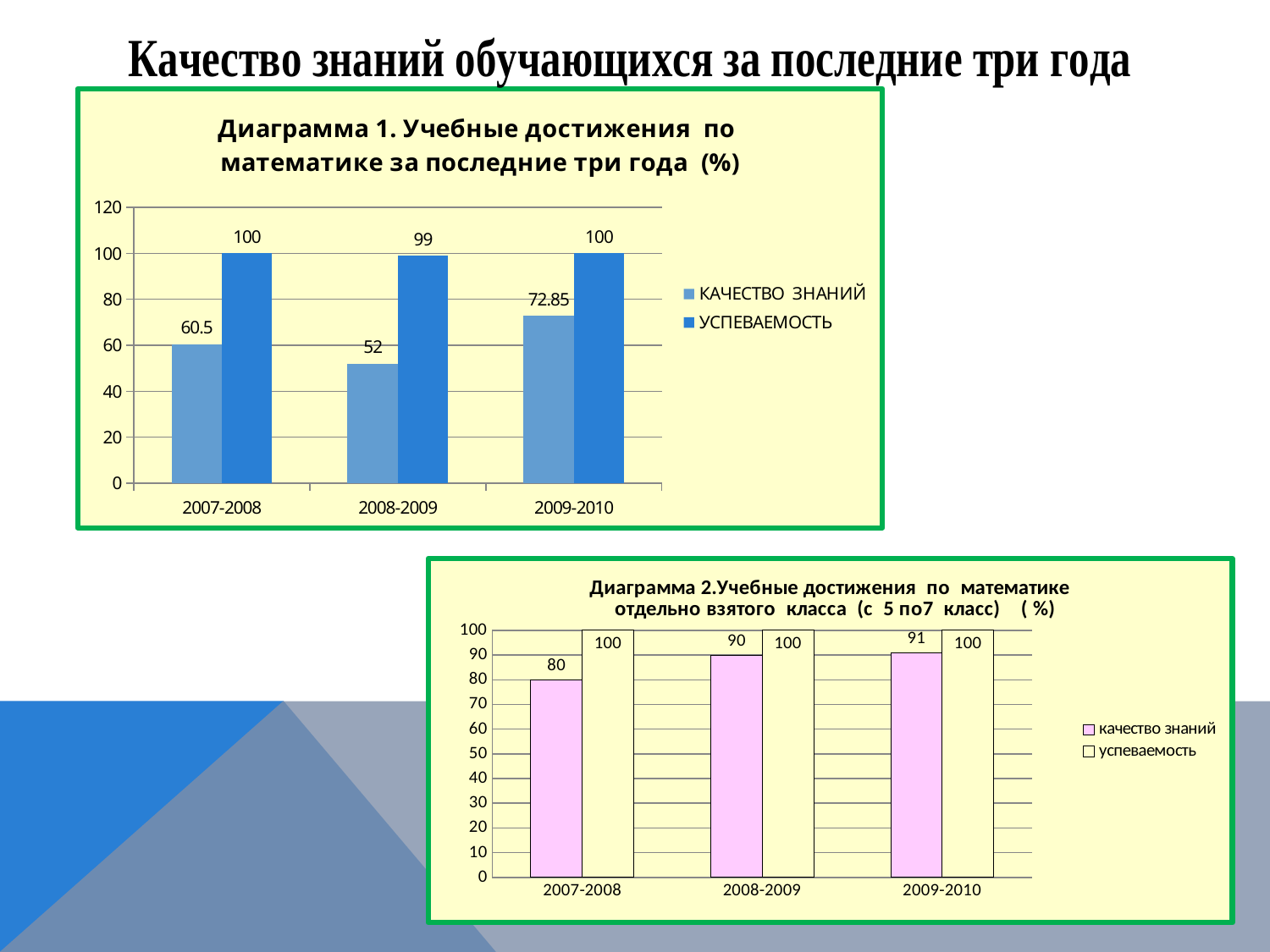
In Диаграмма 1, how many series does the legend list? 2 In Диаграмма 2, how many year categories are shown on the x axis? 3 What type of chart is Диаграмма 2? bar chart In Диаграмма 2, does качество знаний rise or fall from 2007-2008 to 2009-2010? rise In Диаграмма 1, what is the value of КАЧЕСТВО ЗНАНИЙ for 2007-2008? 60.5 In Диаграмма 1, which year has the highest КАЧЕСТВО ЗНАНИЙ value? 2009-2010 In Диаграмма 1, what is the value of УСПЕВАЕМОСТЬ for 2008-2009? 99 In Диаграмма 1, which year has the lowest КАЧЕСТВО ЗНАНИЙ value? 2008-2009 In Диаграмма 2, what is the difference between качество знаний in 2008-2009 and in 2007-2008? 10 In Диаграмма 1, what is the difference between КАЧЕСТВО ЗНАНИЙ in 2009-2010 and in 2008-2009? 20.85 In Диаграмма 2, what is the value of качество знаний for 2009-2010? 91 In Диаграмма 2, what is the value of качество знаний for 2007-2008? 80